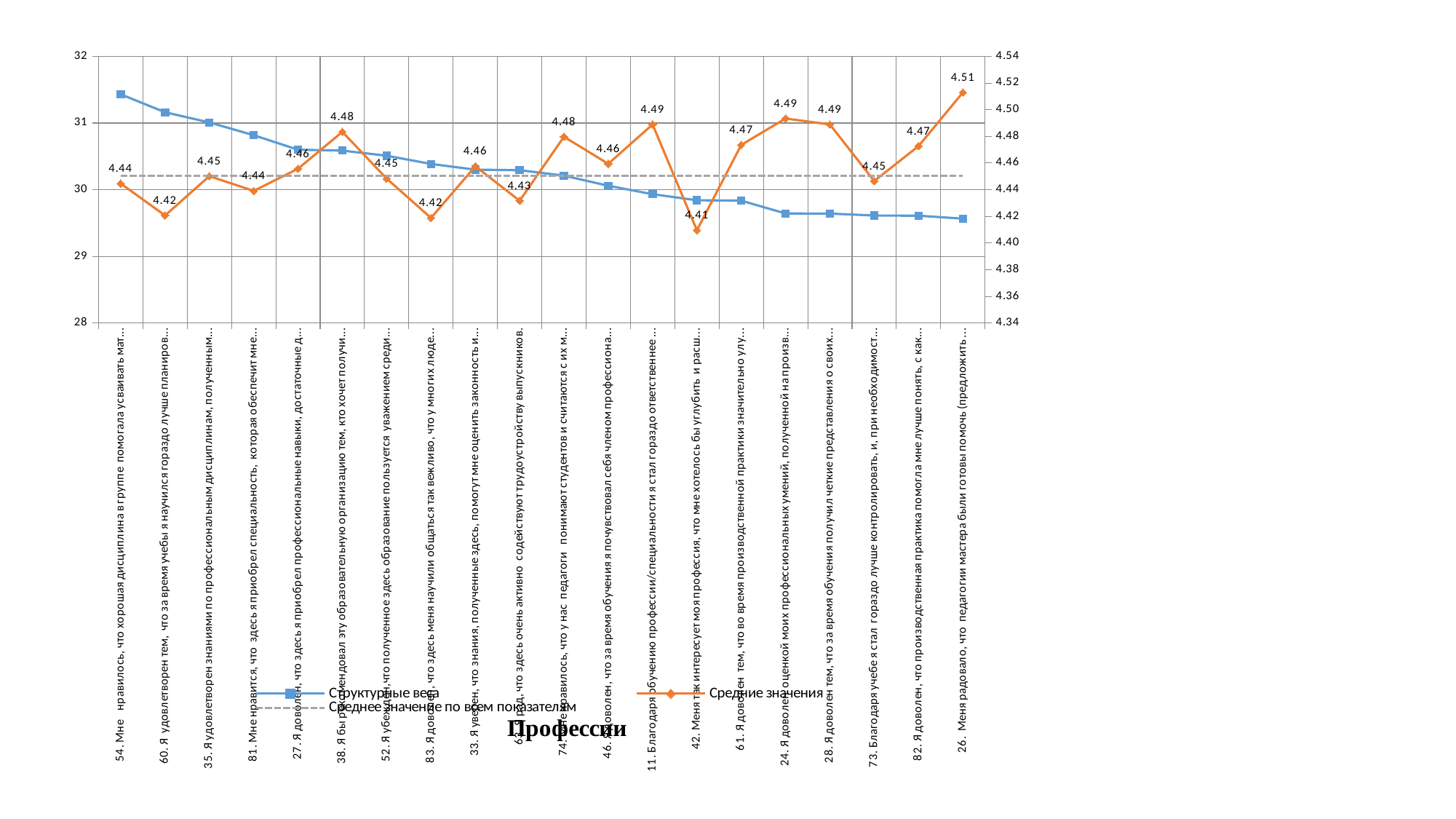
How many categories (statements) are plotted along the x axis? 20 What type of chart is shown on the slide? line chart Which category has the lowest value in the 'Средние значения' series? 42 What is the value of the 'Средние значения' series for statement 11? 4.49 What is the difference between the highest (statement 26) and lowest (statement 42) values of the 'Средние значения' series? 0.10 How many series does the legend list? 3 Is the 'Структурные веса' value for statement 54 (the first category) greater or less than 31? greater Do the values of the 'Структурные веса' series rise or fall from left to right along the x axis? fall Which category has the highest value in the 'Средние значения' series? 26 In the 'Средние значения' series, which is larger: the value for statement 38 or for statement 83? statement 38 What is the value of the 'Средние значения' series for statement 42? 4.41 What is the value of the 'Средние значения' series for statement 26 (the last category)? 4.51